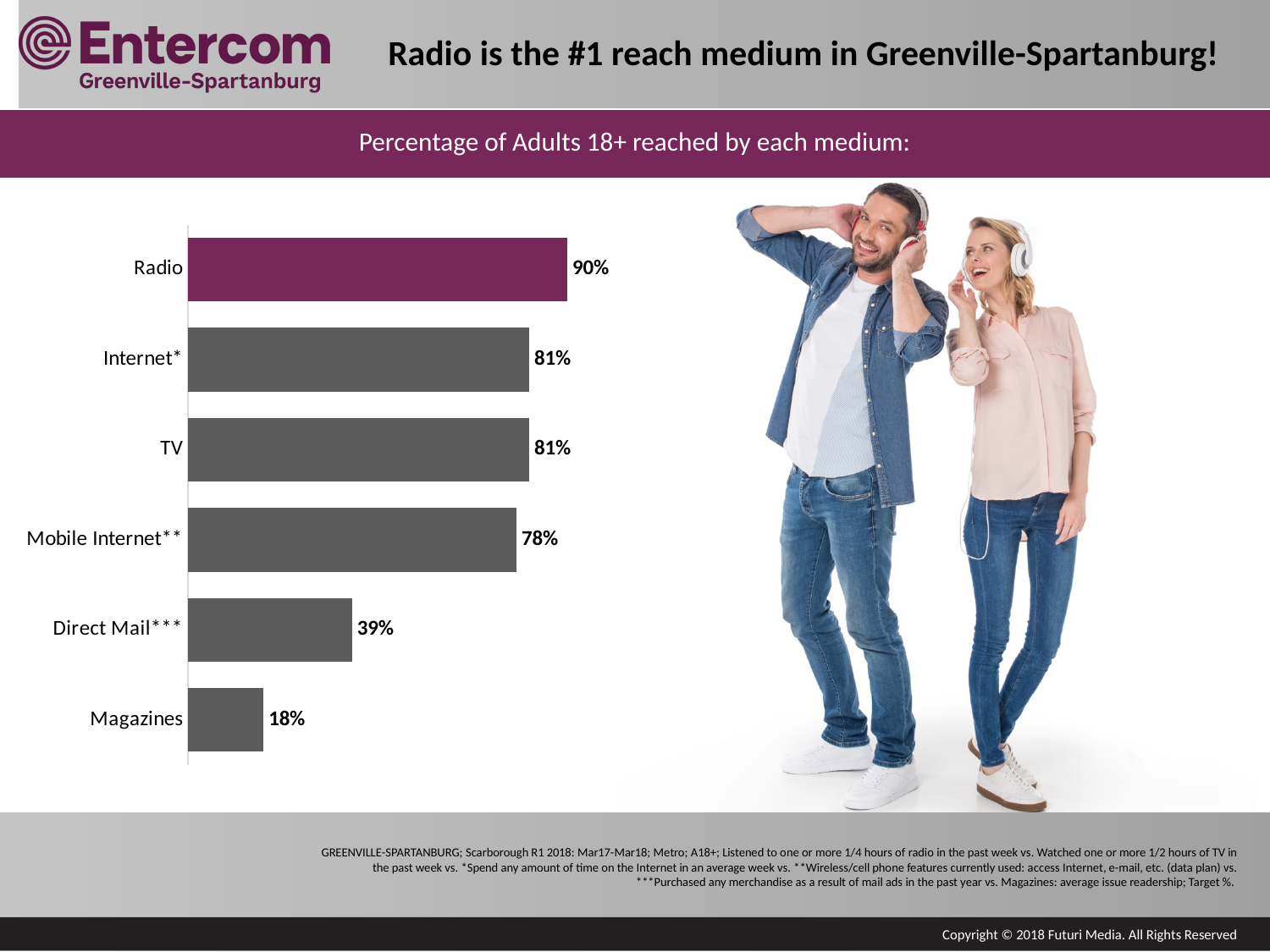
What percentage is shown for Direct Mail***? 39% Which two media share the same value of 81%? Internet* and TV Which bar is shown in a different colour from the others? Radio How many media categories are shown in the chart? 6 Which is larger, the value for Mobile Internet** or the value for Direct Mail***? Mobile Internet** Which medium has the highest reach percentage? Radio Which medium has the lowest reach percentage? Magazines What is the difference between the Radio value and the Magazines value? 72% What percentage of adults 18+ are reached by Radio? 90% What is the value shown for Mobile Internet**? 78% What kind of chart is shown on the slide? Bar chart What is the difference between the Radio value and the TV value? 9%